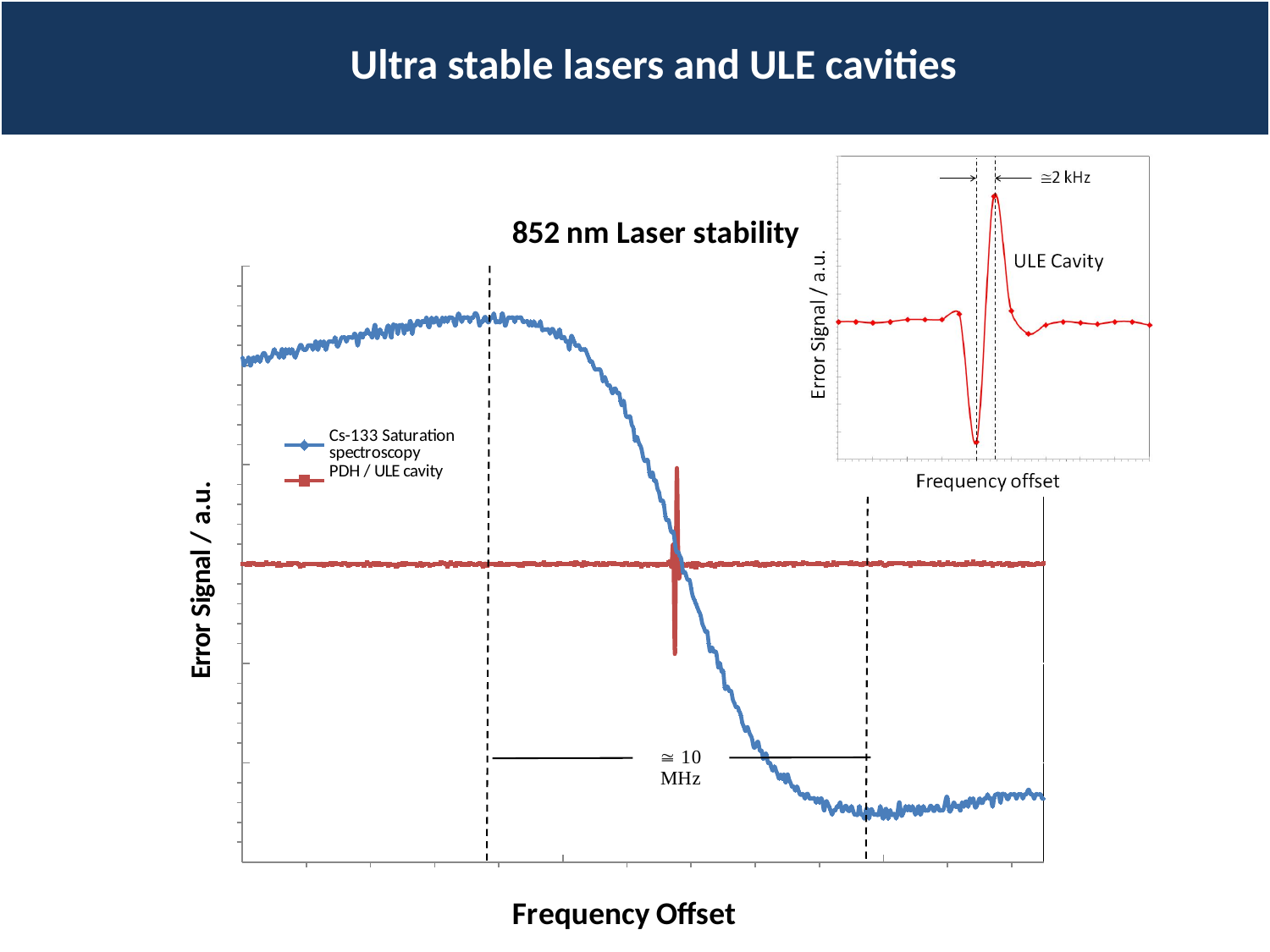
How many series does the legend of the '852 nm Laser stability' chart list? 2 What kind of chart is the main '852 nm Laser stability' chart? line chart In the '852 nm Laser stability' chart, at the far left of the x axis, which series has the higher error signal: Cs-133 Saturation spectroscopy or PDH / ULE cavity? Cs-133 Saturation spectroscopy In the '852 nm Laser stability' chart, which series is drawn in blue? Cs-133 Saturation spectroscopy In the '852 nm Laser stability' chart, does the Cs-133 Saturation spectroscopy signal overall rise or fall from left to right along the x axis? falls What kind of chart is the inset 'ULE Cavity' chart in the top right? line chart How many lines are plotted in the inset 'ULE Cavity' chart? 1 In the inset 'ULE Cavity' chart, what frequency width is annotated between the two vertical dashed lines? ≅2 kHz What is the title of the large chart on the slide? 852 nm Laser stability In the '852 nm Laser stability' chart, at the far right of the x axis, which series has the higher error signal: Cs-133 Saturation spectroscopy or PDH / ULE cavity? PDH / ULE cavity In the '852 nm Laser stability' chart, what frequency width is annotated between the two vertical dashed lines? ≅ 10 MHz